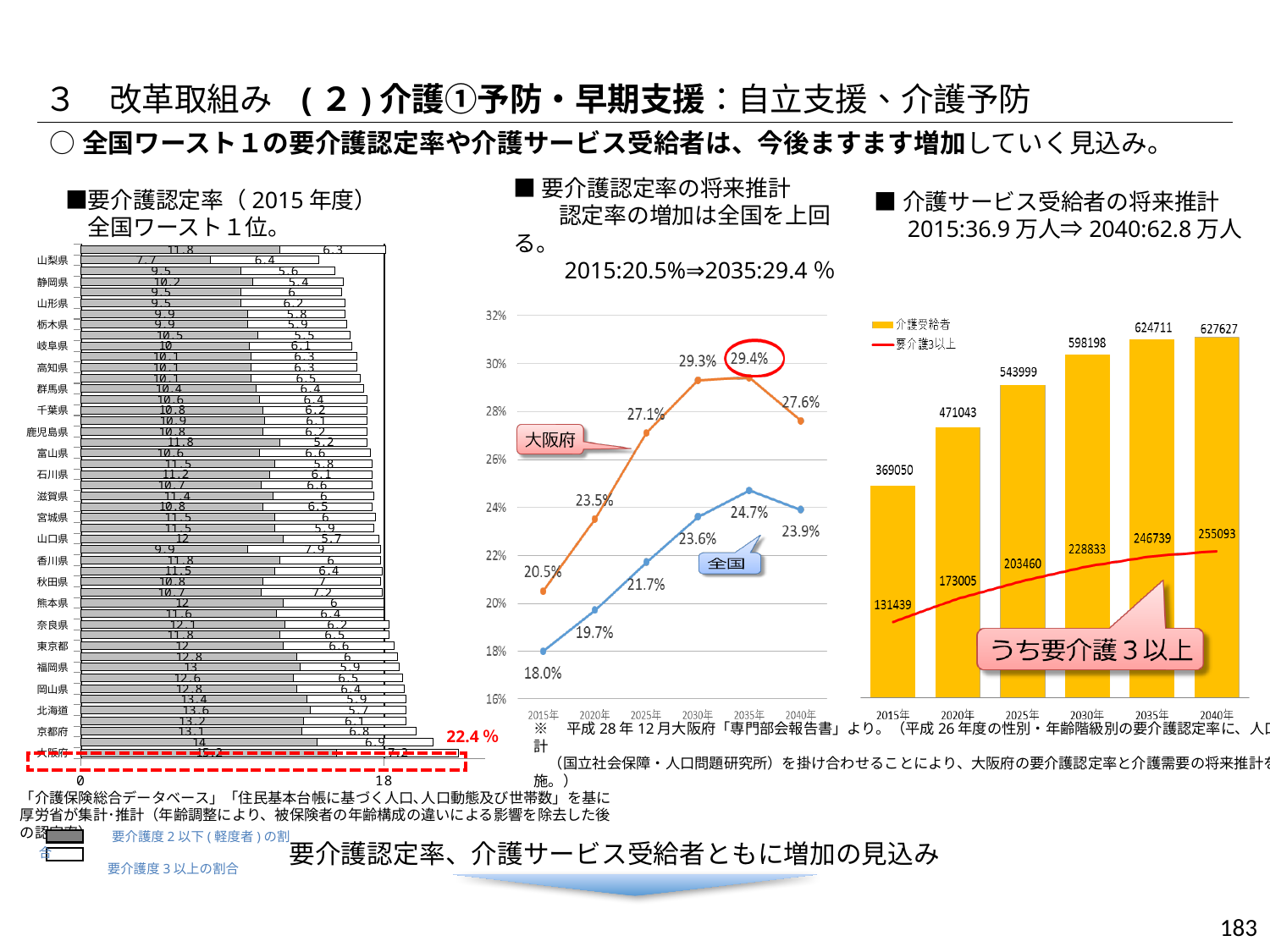
In the 介護サービス受給者の将来推計 chart, what is the difference between the 介護受給者 values for 2040年 and 2015年? 258577 In the 要介護認定率の将来推計 line chart, what is the difference between 大阪府 and 全国 in 2040年? 3.7% In the 要介護認定率の将来推計 line chart, in which year does the 大阪府 series reach its highest value? 2035年 In the 介護サービス受給者の将来推計 chart, which year has the lowest 介護受給者 value? 2015年 In the 介護サービス受給者の将来推計 chart, do the 要介護3以上 values rise or fall from 2015年 to 2040年? rise In the 要介護認定率の将来推計 line chart, what is the value for 全国 in 2015年? 18.0% In the 介護サービス受給者の将来推計 chart, what is the value of 要介護3以上 in 2040年? 255093 In the 要介護認定率の将来推計 line chart, what is the value for 大阪府 in 2035年? 29.4% In the 介護サービス受給者の将来推計 chart, how many series does the legend list? 2 In the 要介護認定率の将来推計 line chart, how many data points does each series have? 6 In the 要介護認定率の将来推計 line chart, which series has the higher value in 2025年, 大阪府 or 全国? 大阪府 In the 介護サービス受給者の将来推計 chart, what is the value of 介護受給者 in 2025年? 543999